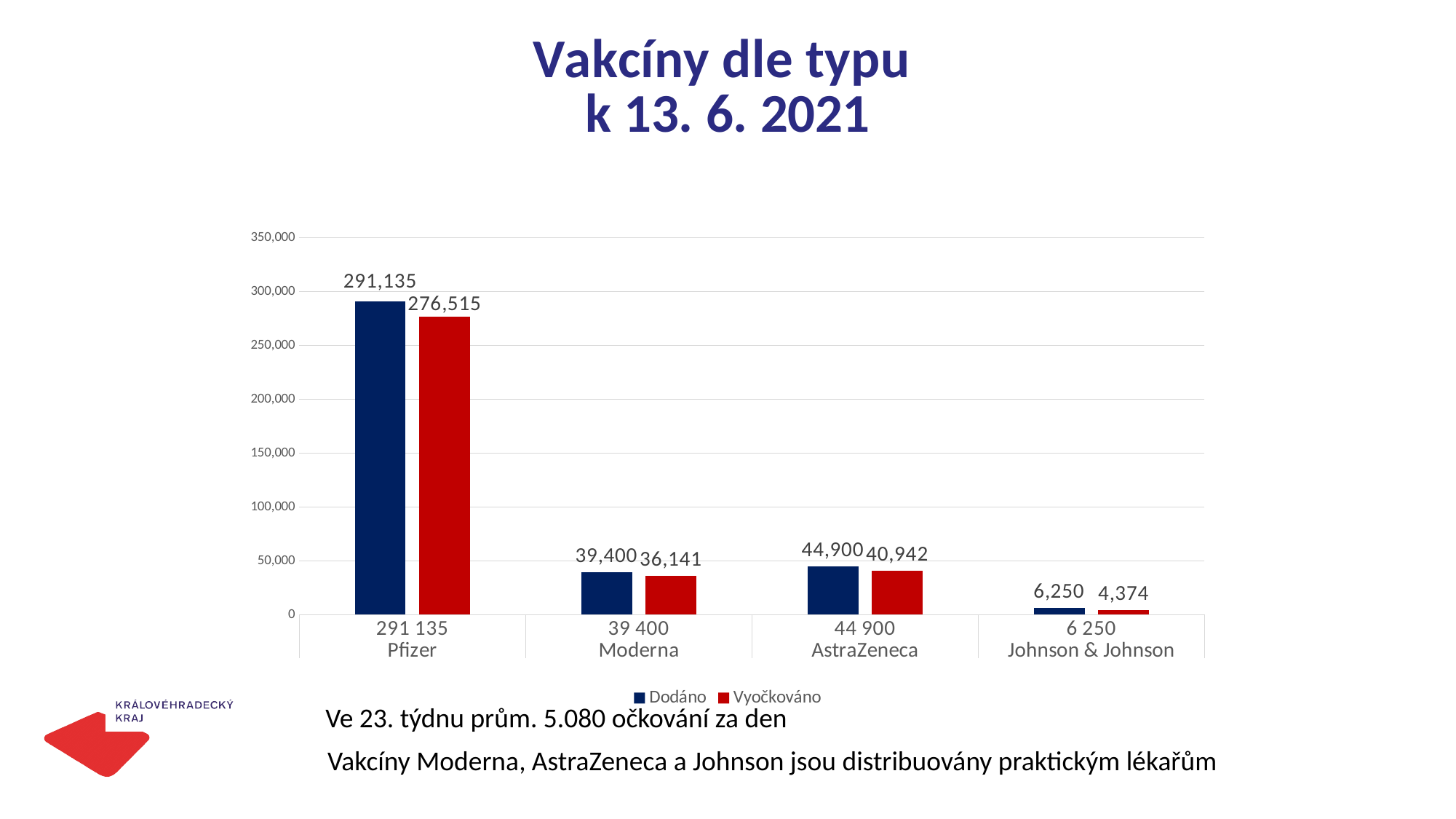
Which vaccine has the lowest Vyočkováno value? Johnson & Johnson What kind of chart is shown on the slide? Bar chart What is the Dodáno value for Pfizer? 291,135 How many series does the legend list? 2 How many vaccine types are shown on the x axis? 4 Which is larger, the Vyočkováno value for AstraZeneca or for Moderna? AstraZeneca What is the Dodáno value for Moderna? 39,400 What is the difference between the Dodáno values for AstraZeneca and Moderna? 5,500 Which vaccine has the highest Dodáno value? Pfizer What is the Vyočkováno value for AstraZeneca? 40,942 What is the Vyočkováno value for Johnson & Johnson? 4,374 What is the difference between the Dodáno and Vyočkováno values for Pfizer? 14,620